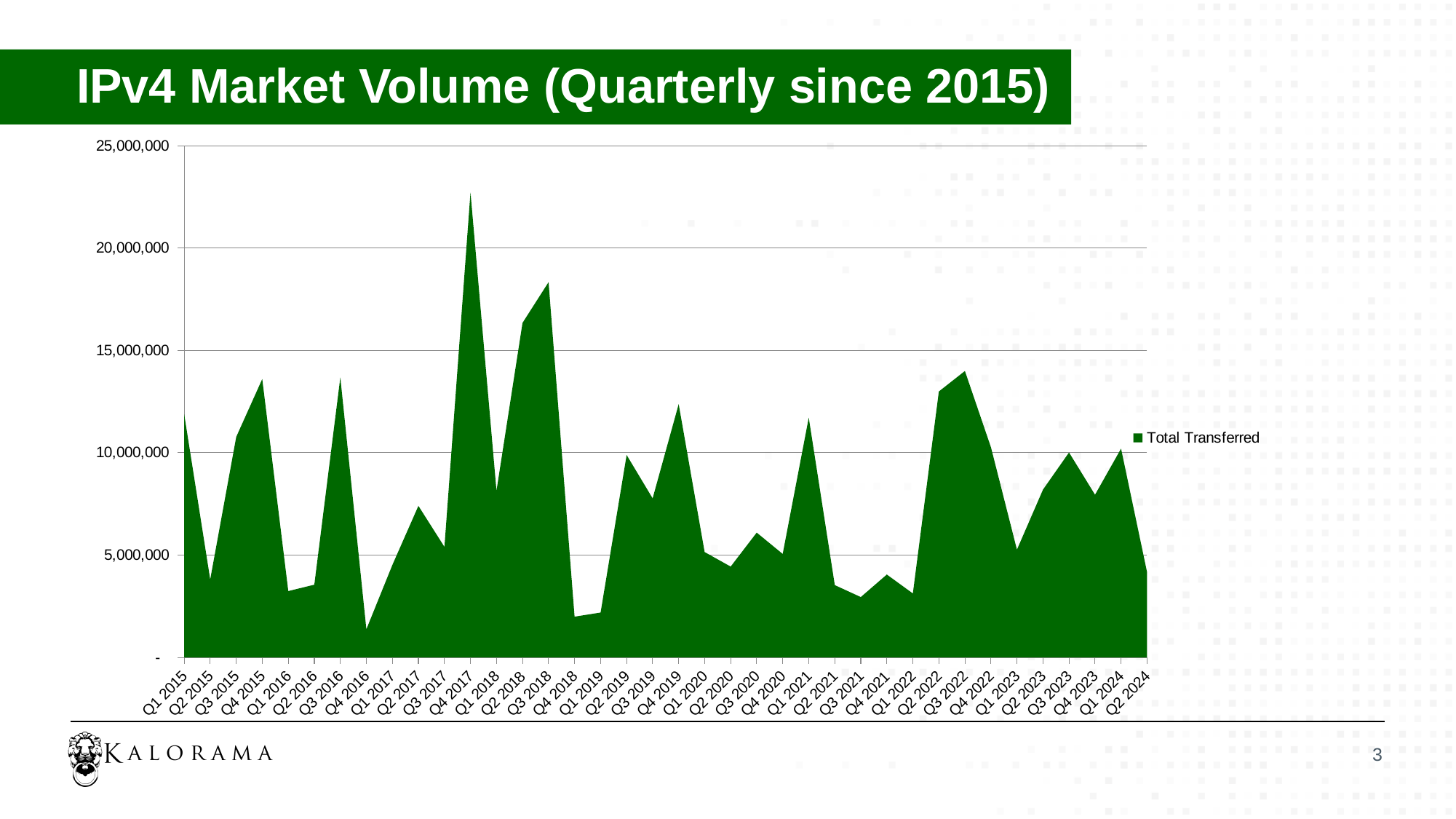
What type of chart is shown on the slide? Area chart Is the value for Q4 2016 greater or less than 5,000,000? less Is the value for Q3 2018 greater or less than 15,000,000? greater Which is larger, the value for Q4 2017 or the value for Q3 2018? Q4 2017 Which quarter has the highest Total Transferred value? Q4 2017 Is the value for Q3 2022 greater or less than 10,000,000? greater What is the title of the chart? IPv4 Market Volume (Quarterly since 2015) How many quarters are plotted along the x axis? 38 How many series does the legend list? 1 Which is larger, the value for Q3 2019 or the value for Q4 2019? Q4 2019 What is the name of the series shown in the legend? Total Transferred